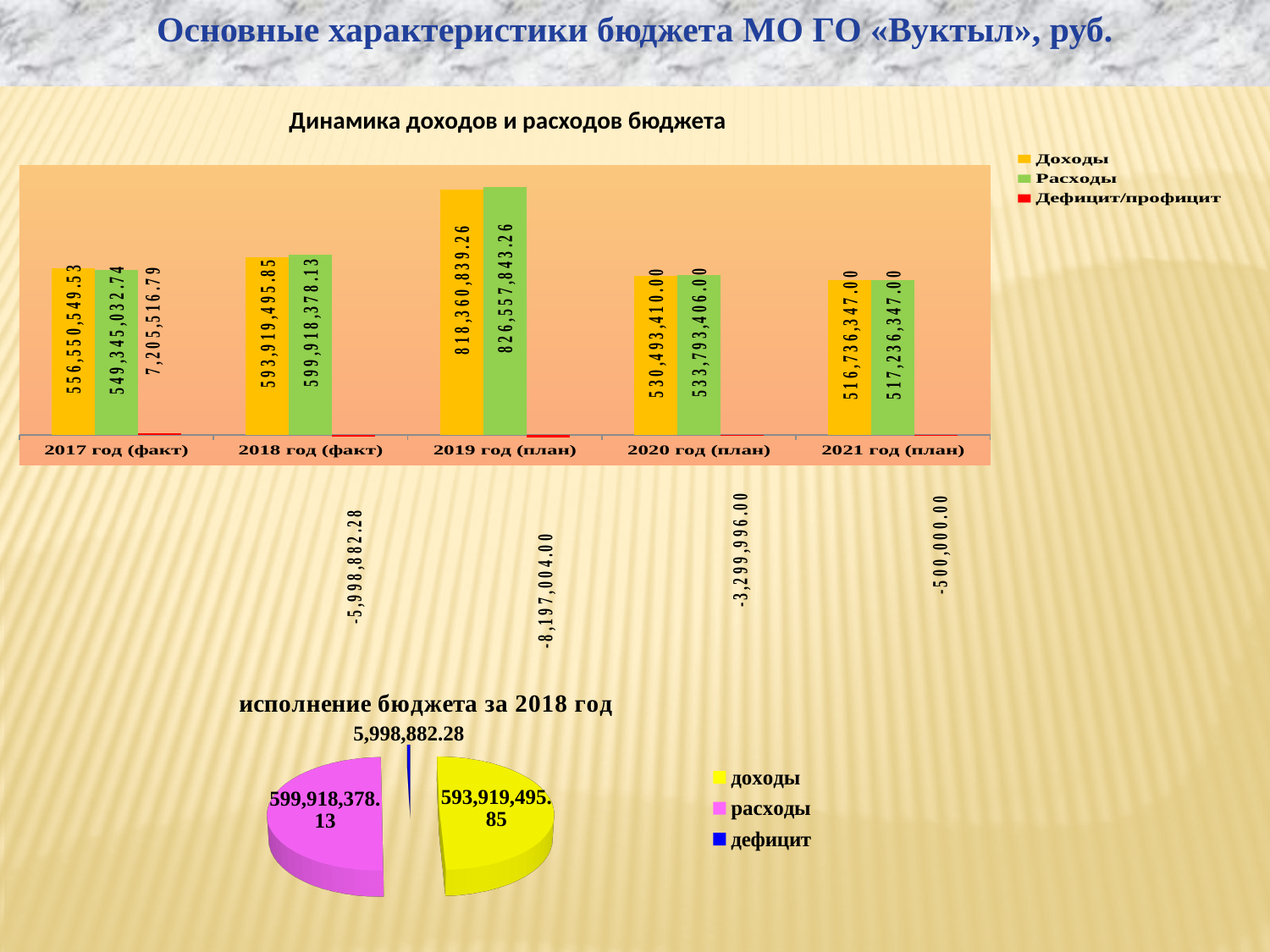
How many year categories are shown in the bar chart 'Динамика доходов и расходов бюджета'? 5 In the pie chart 'исполнение бюджета за 2018 год', what is the value for расходы? 599,918,378.13 In the pie chart 'исполнение бюджета за 2018 год', what is the value for дефицит? 5,998,882.28 In the bar chart 'Динамика доходов и расходов бюджета', which year has the highest Доходы? 2019 год (план) What kind of chart is 'Динамика доходов и расходов бюджета'? Bar chart How many series does the legend of the bar chart 'Динамика доходов и расходов бюджета' list? 3 In the bar chart 'Динамика доходов и расходов бюджета', what is the Дефицит/профицит value for 2020 год (план)? -3,299,996.00 In the bar chart 'Динамика доходов и расходов бюджета', which is larger for 2017 год (факт): Доходы or Расходы? Доходы In the bar chart 'Динамика доходов и расходов бюджета', what is the value of Расходы for 2017 год (факт)? 549,345,032.74 In the bar chart 'Динамика доходов и расходов бюджета', which year has the lowest Расходы? 2021 год (план) In the bar chart 'Динамика доходов и расходов бюджета', what is the difference between Расходы and Доходы for 2019 год (план)? 8,197,004.00 In the bar chart 'Динамика доходов и расходов бюджета', what is the value of Доходы for 2019 год (план)? 818,360,839.26